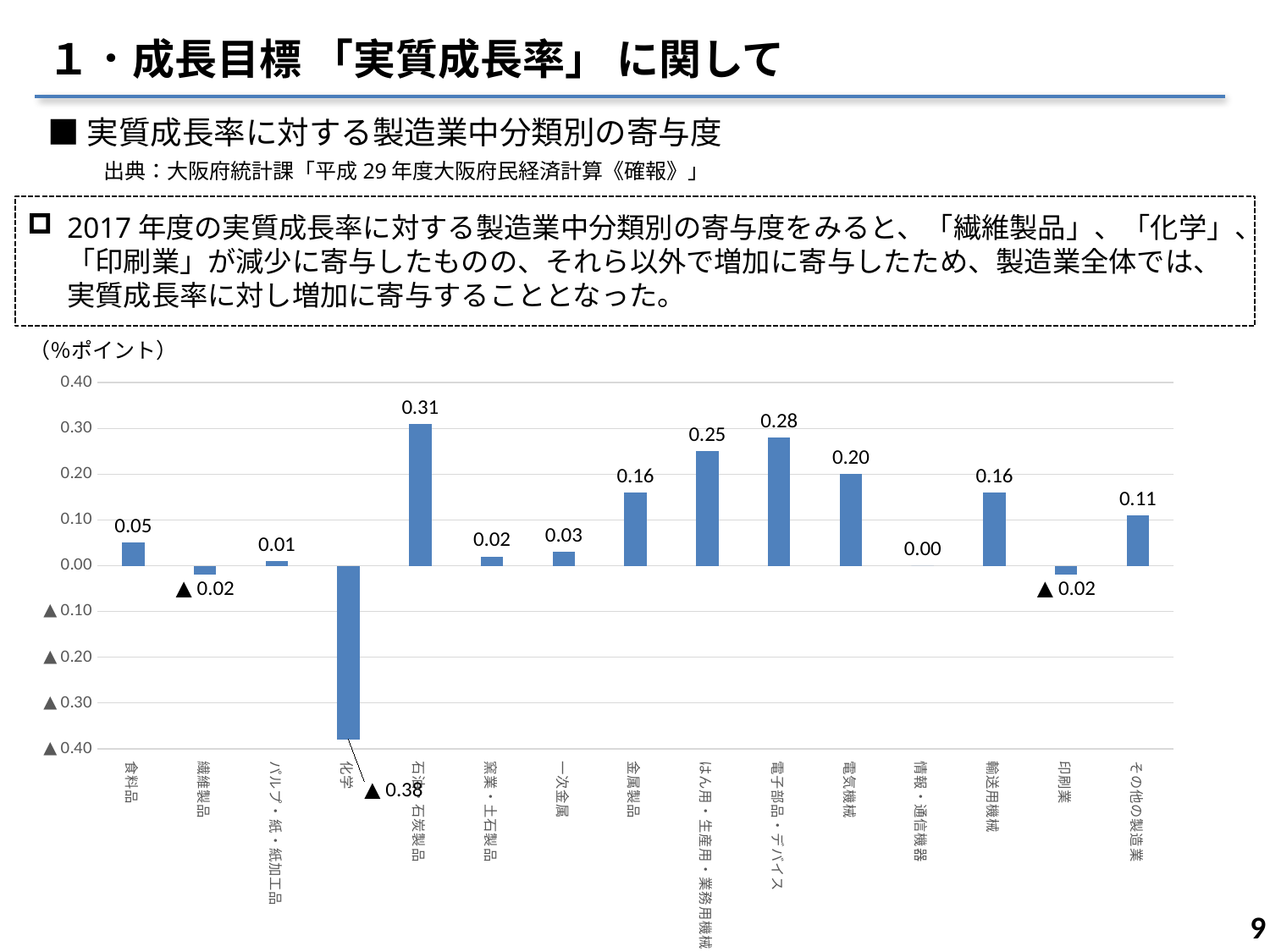
What is the value for 情報・通信機器? 0.00 Which is larger, the value for 金属製品 or the value for はん用・生産用・業務用機械? はん用・生産用・業務用機械 What is the value for 印刷業? ▲ 0.02 What unit is shown above the chart's vertical axis? %ポイント What is the value for 電子部品・デバイス? 0.28 Which category has the lowest value? 化学 What is the value for 石油・石炭製品? 0.31 What is the value for 化学? ▲ 0.38 What is the difference between the values for 電子部品・デバイス and 電気機械? 0.08 What kind of chart is this? bar chart Which category has the highest value? 石油・石炭製品 How many categories are shown on the x axis? 15